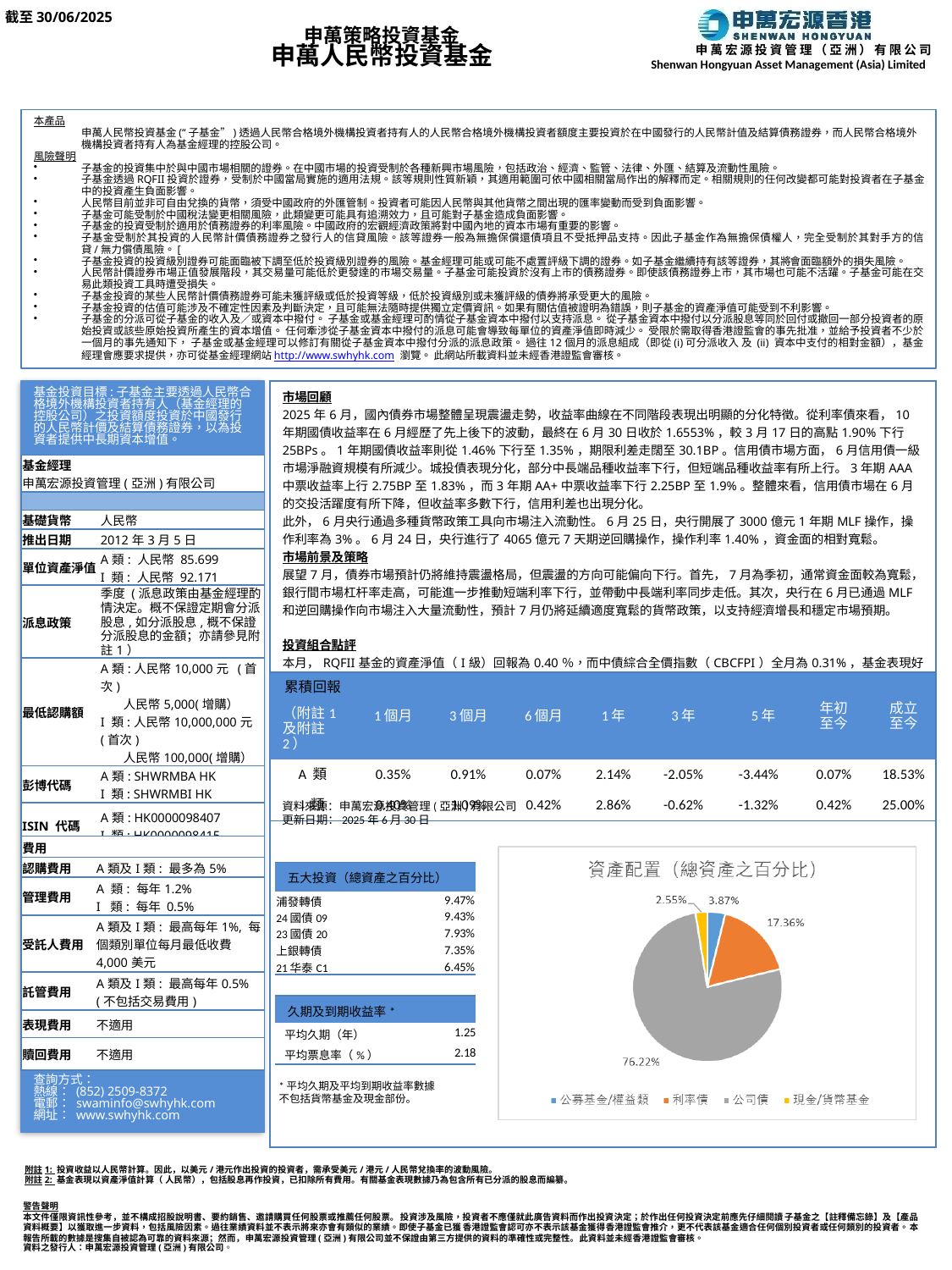
What kind of chart is the 資產配置（總資產之百分比） chart? pie chart How many entries does the legend of the 資產配置（總資產之百分比） pie chart list? 4 In the 資產配置（總資產之百分比） pie chart, what share is 利率債? 17.36% Which category has the largest slice in the 資產配置（總資產之百分比） pie chart? 公司債 How many slices does the 資產配置（總資產之百分比） pie chart have? 4 What colour is the 公司債 slice in the 資產配置（總資產之百分比） pie chart? grey Which category has the smallest slice in the 資產配置（總資產之百分比） pie chart? 現金/貨幣基金 In the 資產配置（總資產之百分比） pie chart, what share is 現金/貨幣基金? 2.55% In the 資產配置（總資產之百分比） pie chart, what share is 公募基金/權益類? 3.87% In the 資產配置（總資產之百分比） pie chart, which is larger, 利率債 or 公募基金/權益類? 利率債 In the 資產配置（總資產之百分比） pie chart, what is the difference in percentage points between 公司債 and 利率債? 58.86